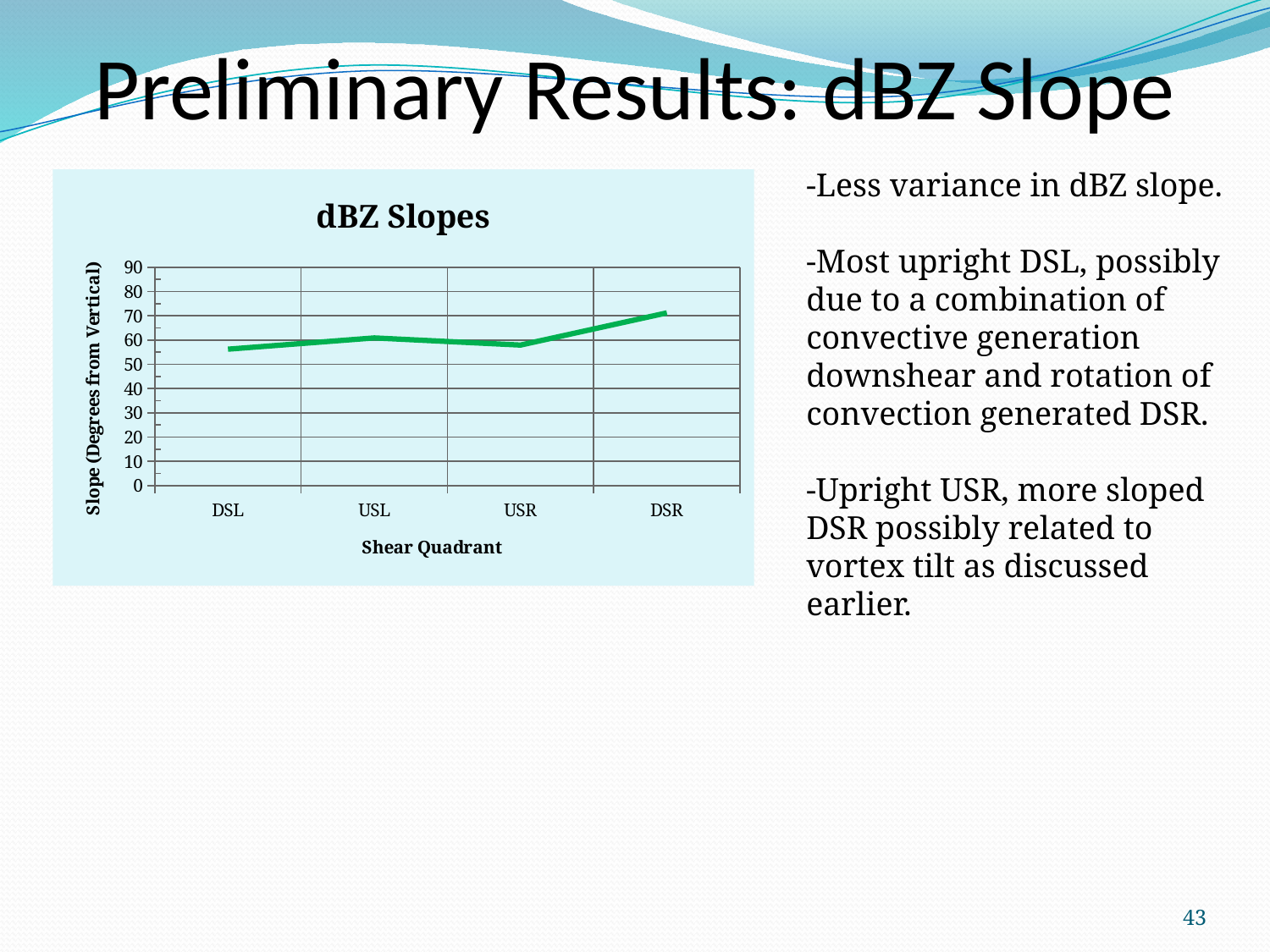
What kind of chart is shown on the slide? line chart Is the value for DSL greater or less than 60? less Which has a larger dBZ slope, DSL or DSR? DSR Which shear quadrant has the highest dBZ slope? DSR Is the value for USL greater or less than 80? less Is the value for USR greater or less than 50? greater Does the line rise or fall between USR and DSR? rise How many shear quadrant categories are plotted on the x axis? 4 Which has a larger dBZ slope, USL or DSR? DSR What is the label of the x axis of the chart? Shear Quadrant What is the title of the chart? dBZ Slopes